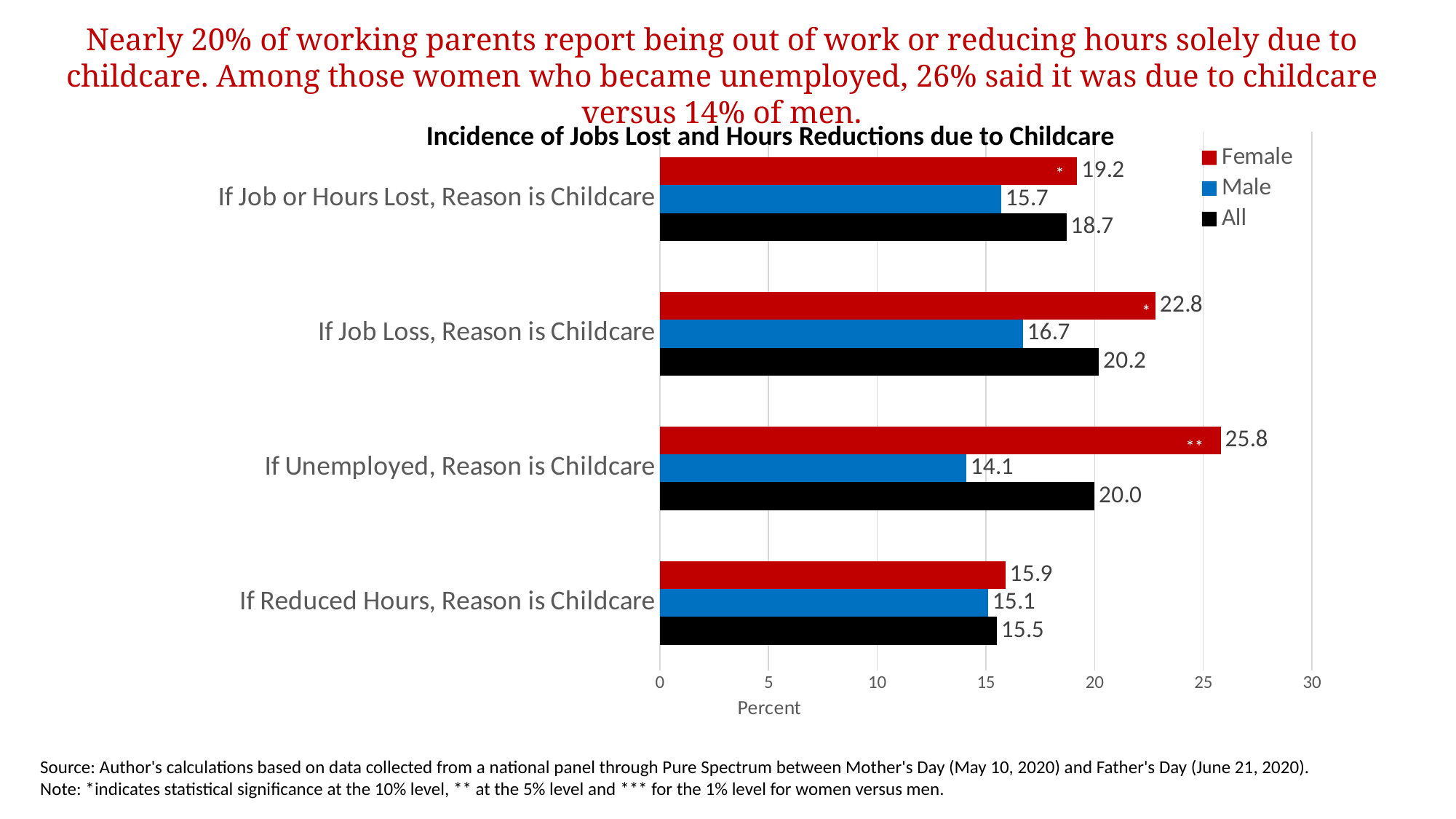
What is the All value for "If Reduced Hours, Reason is Childcare"? 15.5 Which category has the lowest Male value? If Unemployed, Reason is Childcare What is the difference between the Female and Male values for "If Unemployed, Reason is Childcare"? 11.7 Which colour represents the Male series in the chart? Blue What is the Male value for "If Job Loss, Reason is Childcare"? 16.7 How many series does the legend list? 3 What is the Female value for "If Unemployed, Reason is Childcare"? 25.8 Which is larger for "If Job or Hours Lost, Reason is Childcare": the Female value or the All value? Female What is the title of the chart? Incidence of Jobs Lost and Hours Reductions due to Childcare How many categories are shown on the chart? 4 Which category has the highest Female value? If Unemployed, Reason is Childcare What kind of chart is shown on the slide? Bar chart